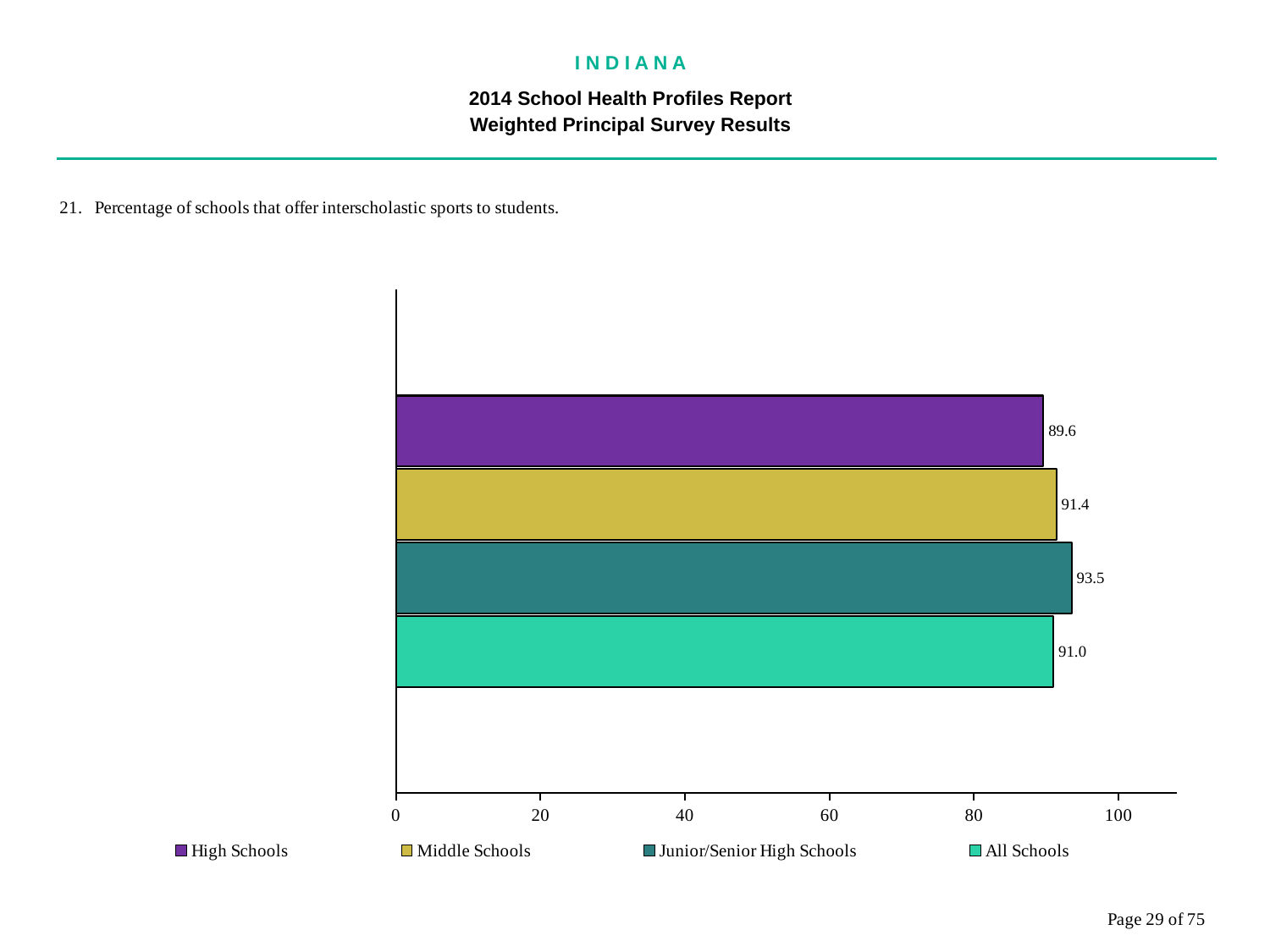
What is the value for High Schools? 89.6 What is the value for All Schools? 91.0 What is the value for Junior/Senior High Schools? 93.5 Which is larger, the value for Middle Schools or the value for High Schools? Middle Schools Which school type has the lowest value? High Schools What is the difference between the values for Junior/Senior High Schools and High Schools? 3.9 What is the value for Middle Schools? 91.4 How many series does the legend list? 4 Is the value for All Schools greater or less than 80? greater Which school type has the highest value? Junior/Senior High Schools What is the difference between the values for Middle Schools and All Schools? 0.4 What kind of chart is shown on the slide? Bar chart